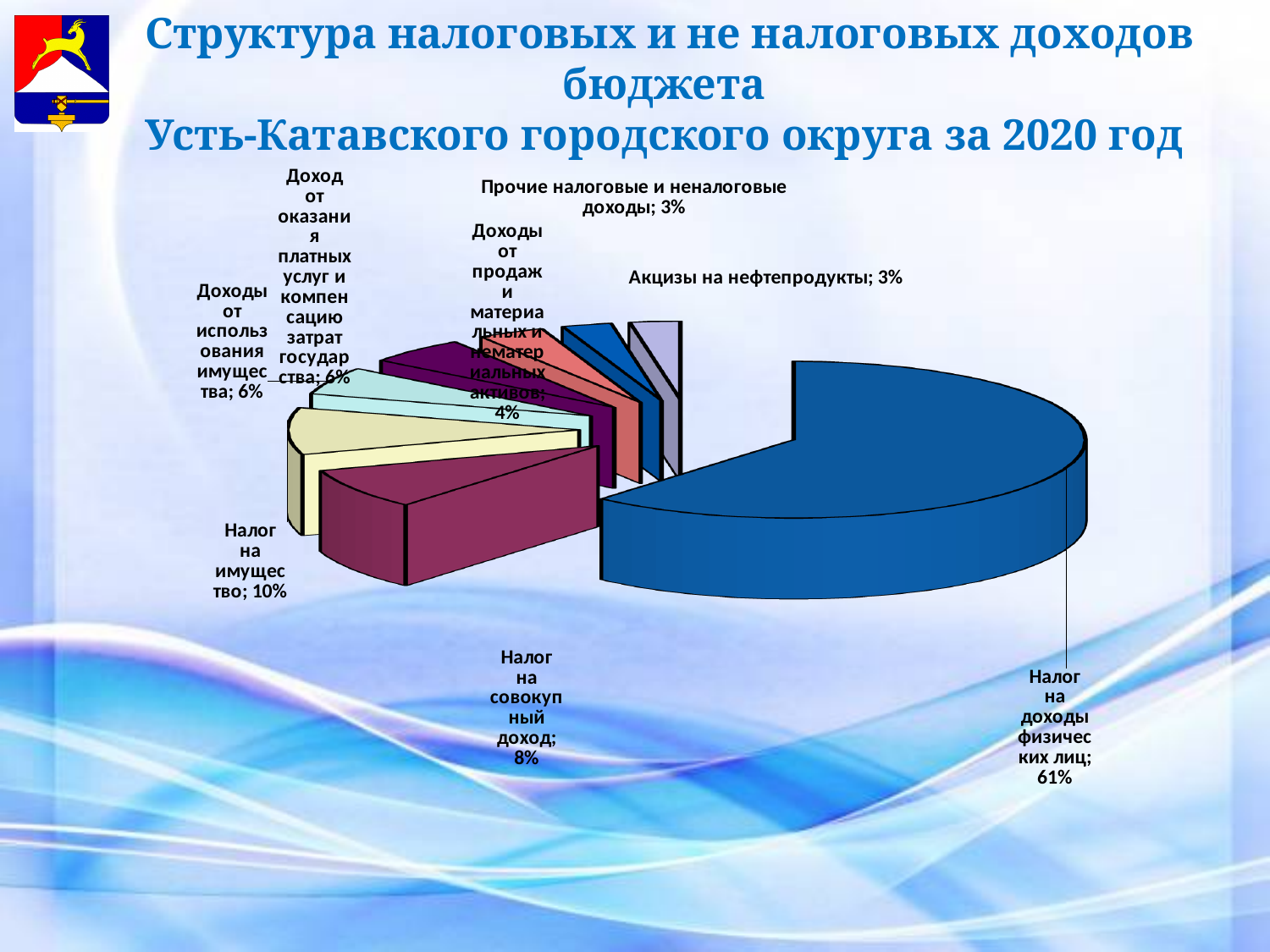
Какую долю составляют доходы от продаж материальных и нематериальных активов? 4% Какую долю составляет налог на доходы физических лиц? 61% Какую долю составляет налог на имущество? 10% Какая категория имеет наибольшую долю в структуре доходов? Налог на доходы физических лиц Какой тип диаграммы показан на слайде? Круговая диаграмма На сколько процентных пунктов доля налога на имущество больше доли налога на совокупный доход? 2 Сколько категорий (секторов) показано на диаграмме? 8 Какую долю составляет налог на совокупный доход? 8% Какую долю составляют акцизы на нефтепродукты? 3% За какой год показана структура доходов бюджета Усть-Катавского городского округа? 2020 На сколько процентных пунктов доля налога на доходы физических лиц больше доли налога на имущество? 51 Что больше: доля доходов от использования имущества или доля доходов от продаж материальных и нематериальных активов? Доходы от использования имущества